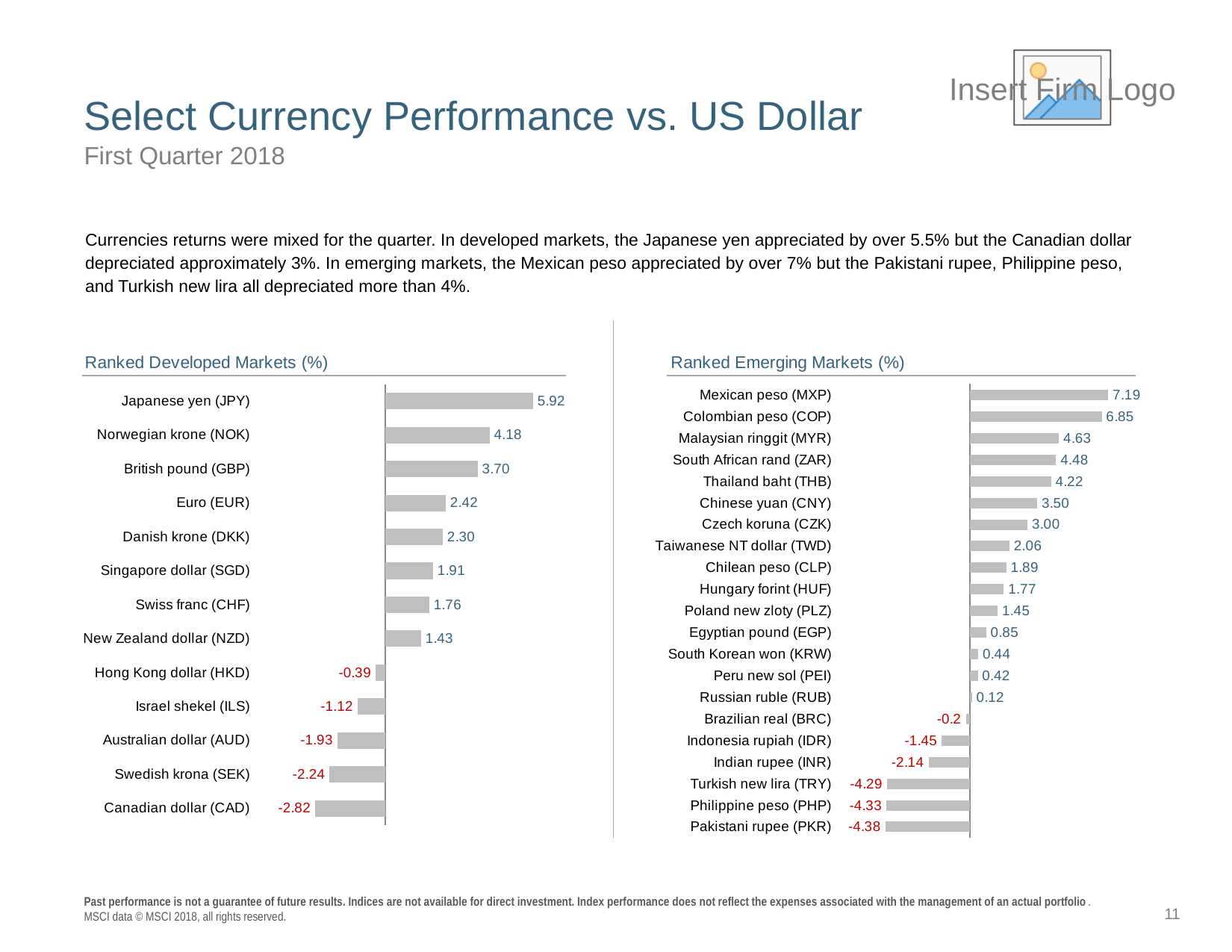
In the Ranked Developed Markets (%) chart, what is the difference between the Japanese yen (JPY) and the Norwegian krone (NOK)? 1.74 How many currencies are shown in the Ranked Emerging Markets (%) chart? 21 In the Ranked Developed Markets (%) chart, which currency has the lowest value? Canadian dollar (CAD) In the Ranked Emerging Markets (%) chart, what is the value for the Russian ruble (RUB)? 0.12 What type of chart is the Ranked Emerging Markets (%) chart? Bar chart In the Ranked Developed Markets (%) chart, what is the value for the Japanese yen (JPY)? 5.92 How many currencies are shown in the Ranked Developed Markets (%) chart? 13 In the Ranked Developed Markets (%) chart, what is the value for the Hong Kong dollar (HKD)? -0.39 In the Ranked Emerging Markets (%) chart, what is the difference between the Mexican peso (MXP) and the Colombian peso (COP)? 0.34 In the Ranked Emerging Markets (%) chart, what is the value for the Turkish new lira (TRY)? -4.29 In the Ranked Developed Markets (%) chart, which is larger, the value for the British pound (GBP) or the Euro (EUR)? British pound (GBP) In the Ranked Emerging Markets (%) chart, which currency has the highest value? Mexican peso (MXP)